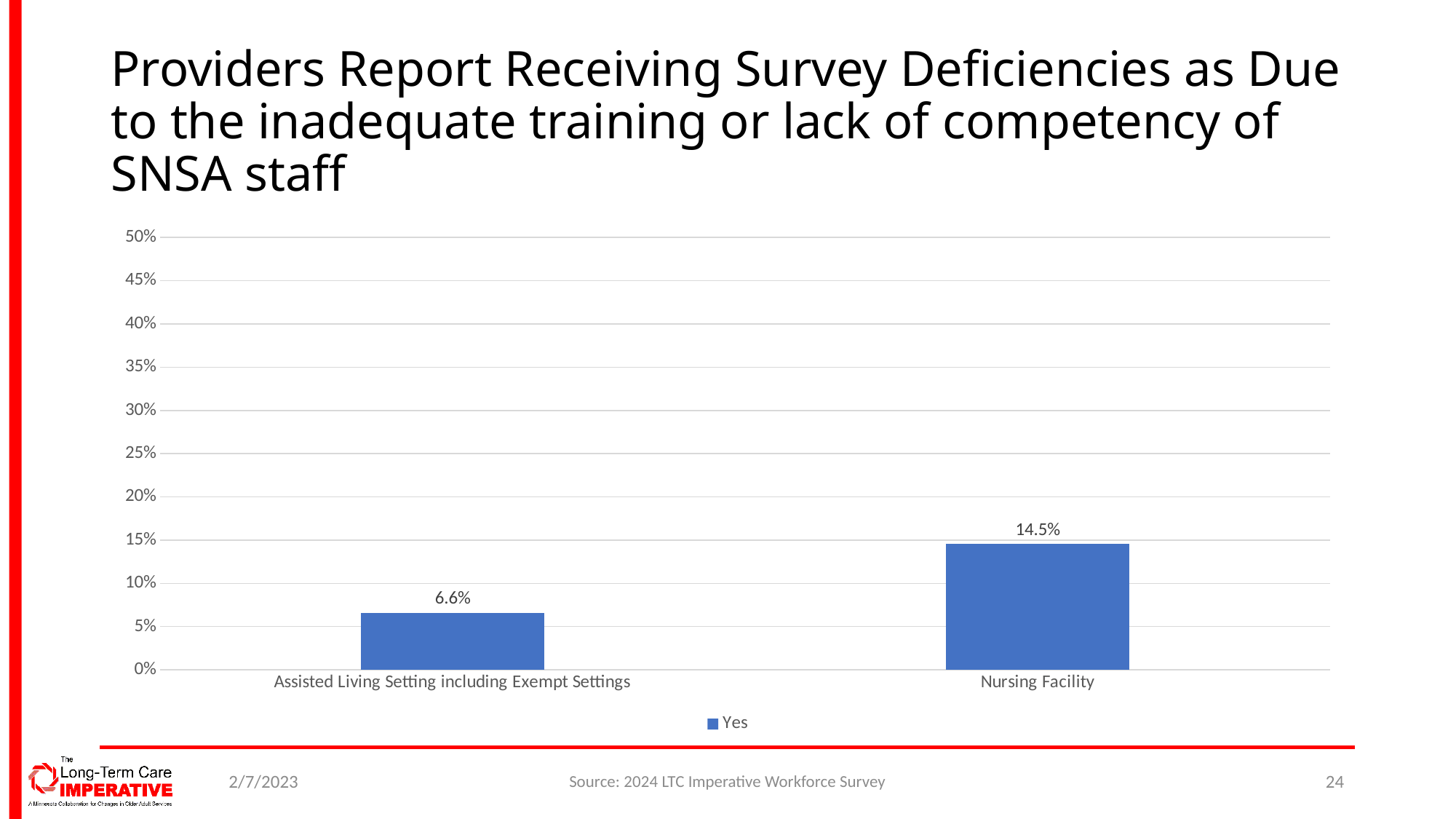
What is the value for Assisted Living Setting including Exempt Settings? 6.6% Which category has the lowest value? Assisted Living Setting including Exempt Settings Is the value for Assisted Living Setting including Exempt Settings greater or less than 10%? less What is the name of the series listed in the legend? Yes What is the difference between the values for Nursing Facility and Assisted Living Setting including Exempt Settings? 7.9% How many categories are shown on the x axis? 2 What kind of chart is shown on the slide? Bar chart What is the value for Nursing Facility? 14.5% Is the value for Nursing Facility greater or less than 10%? greater How many series does the legend list? 1 Which category has the highest value? Nursing Facility Which is larger, the value for Nursing Facility or the value for Assisted Living Setting including Exempt Settings? Nursing Facility